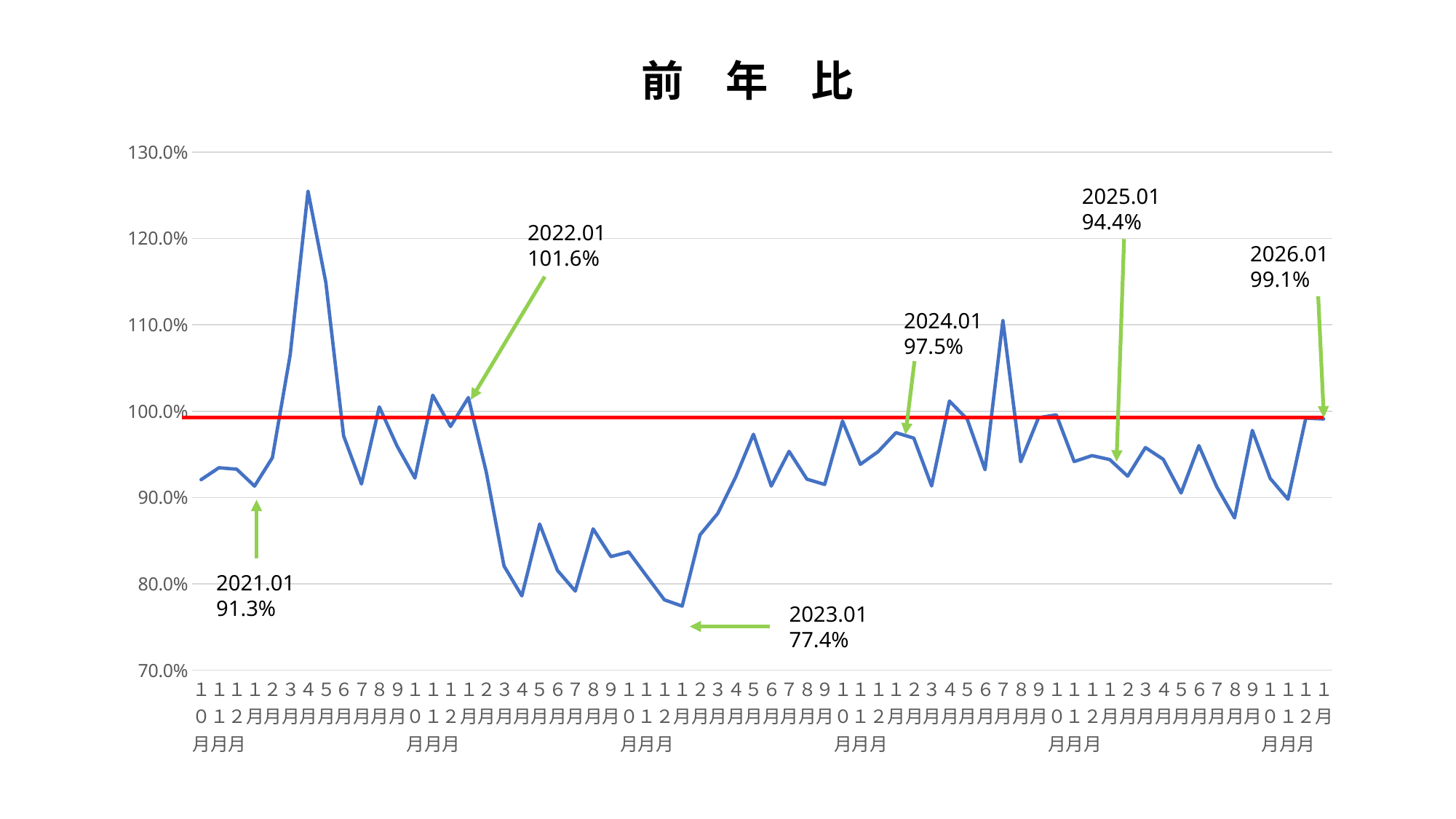
What type of chart is shown on the slide? Line chart What is the value annotated for 2024.01? 97.5% What is the value annotated for 2026.01? 99.1% What is the value annotated for 2023.01? 77.4% By how many percentage points does the 2022.01 value exceed the 2021.01 value? 10.3 percentage points What is the value annotated for 2021.01? 91.3% Among the six annotated January values, which has the lowest value? 2023.01 What is the value annotated for 2025.01? 94.4% Is the highest peak of the line (around April 2021) greater or less than 120.0%? greater What is the value annotated for 2022.01? 101.6% Which is larger, the value for 2024.01 or the value for 2025.01? 2024.01 Among the six annotated January values, which has the highest value? 2022.01